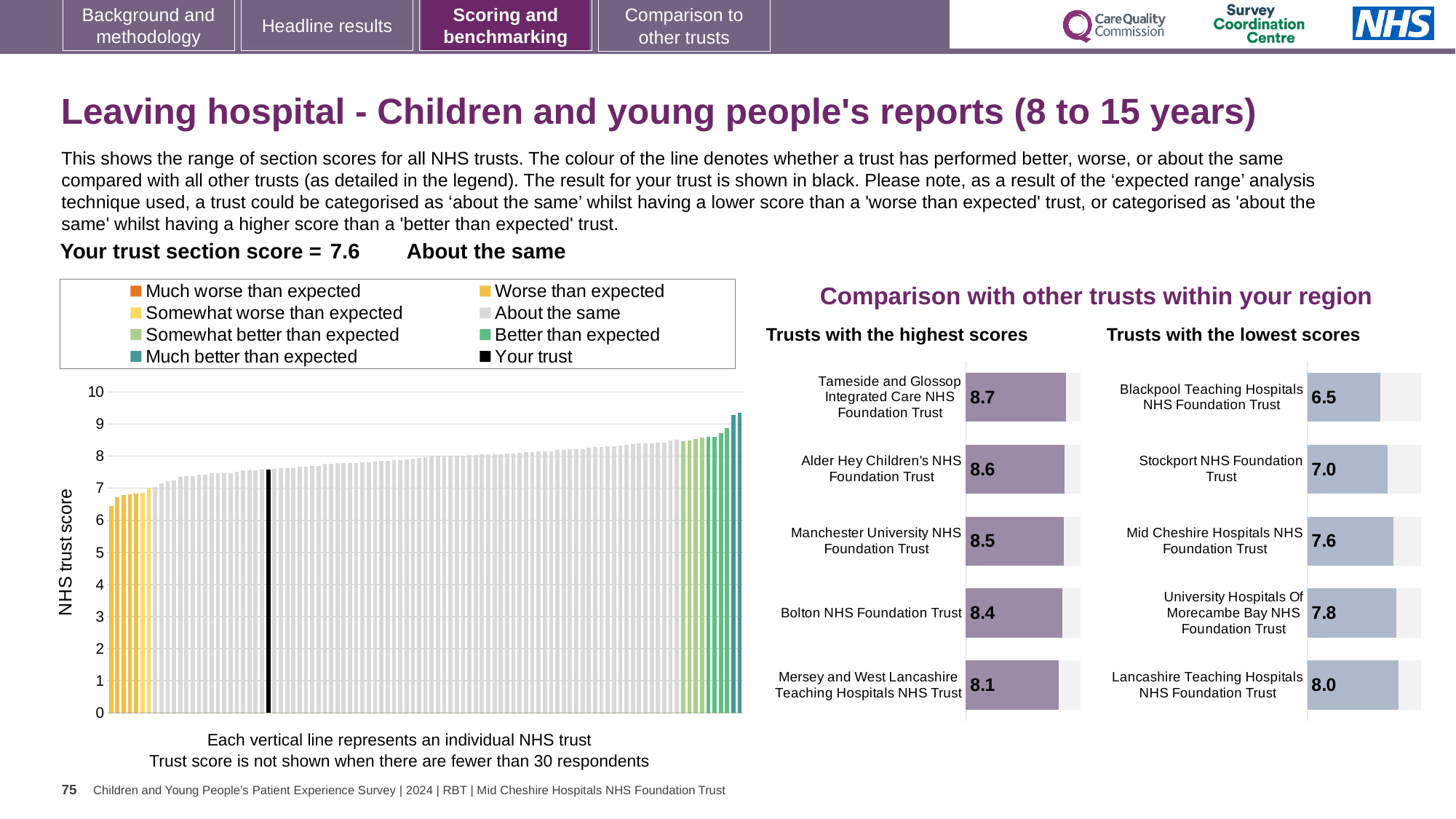
In the 'Trusts with the lowest scores' chart, which has the higher score: Stockport NHS Foundation Trust or Mid Cheshire Hospitals NHS Foundation Trust? Mid Cheshire Hospitals NHS Foundation Trust In the main NHS trust score chart on the left, do the values rise or fall from left to right? rise In the 'Trusts with the highest scores' chart, what is the score for Tameside and Glossop Integrated Care NHS Foundation Trust? 8.7 In the main NHS trust score chart on the left, is the value for the lowest-scoring trust greater or less than 7? less In the 'Trusts with the highest scores' chart, what is the score for Bolton NHS Foundation Trust? 8.4 In the 'Trusts with the lowest scores' chart, what is the score for Blackpool Teaching Hospitals NHS Foundation Trust? 6.5 In the 'Trusts with the highest scores' chart, which trust has the lowest score? Mersey and West Lancashire Teaching Hospitals NHS Trust How many trusts are shown in the 'Trusts with the lowest scores' chart? 5 In the 'Trusts with the lowest scores' chart, what is the difference between the scores of Lancashire Teaching Hospitals NHS Foundation Trust and Blackpool Teaching Hospitals NHS Foundation Trust? 1.5 In the 'Trusts with the highest scores' chart, what is the difference between the scores of Tameside and Glossop Integrated Care NHS Foundation Trust and Mersey and West Lancashire Teaching Hospitals NHS Trust? 0.6 How many entries does the legend of the main NHS trust score chart on the left list? 8 In the 'Trusts with the lowest scores' chart, which trust has the highest score? Lancashire Teaching Hospitals NHS Foundation Trust